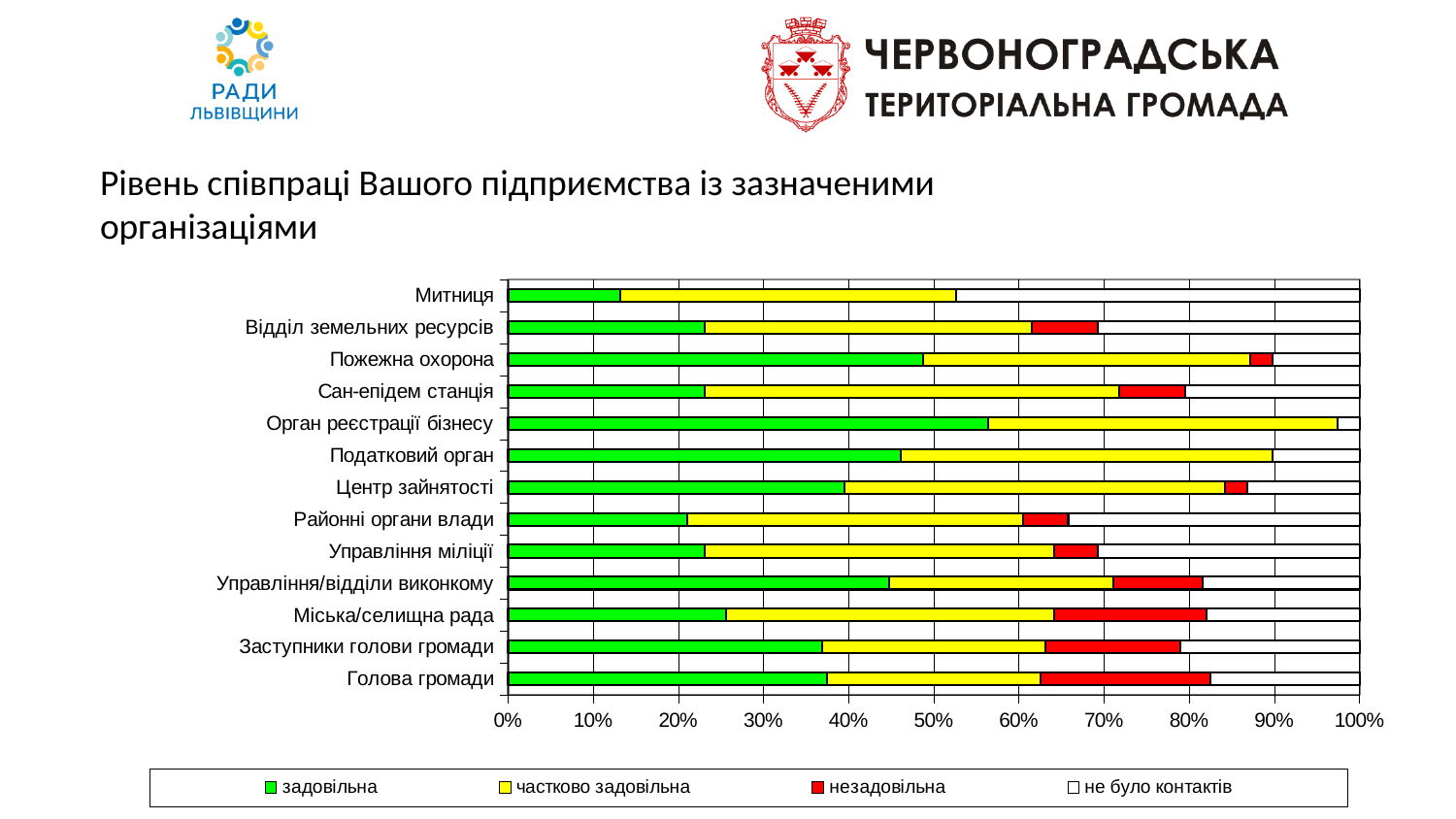
How many organisations (categories) are listed on the vertical axis of the chart? 13 What kind of chart is shown on the slide? bar chart Is the green (задовільна) value for Податковий орган greater or less than 40%? greater Which organisation has the smallest green (задовільна) segment? Митниця Which has the larger green (задовільна) segment: Центр зайнятості or Районні органи влади? Центр зайнятості How many series does the chart legend list? 4 Which has the larger green (задовільна) segment: Митниця or Голова громади? Голова громади Is the green (задовільна) value for Орган реєстрації бізнесу greater or less than 50%? greater What is the title of the chart on the slide? Рівень співпраці Вашого підприємства із зазначеними організаціями Is the green (задовільна) value for Митниця greater or less than 20%? less Which legend entry is shown in red? незадовільна Which organisation has the largest green (задовільна) segment? Орган реєстрації бізнесу